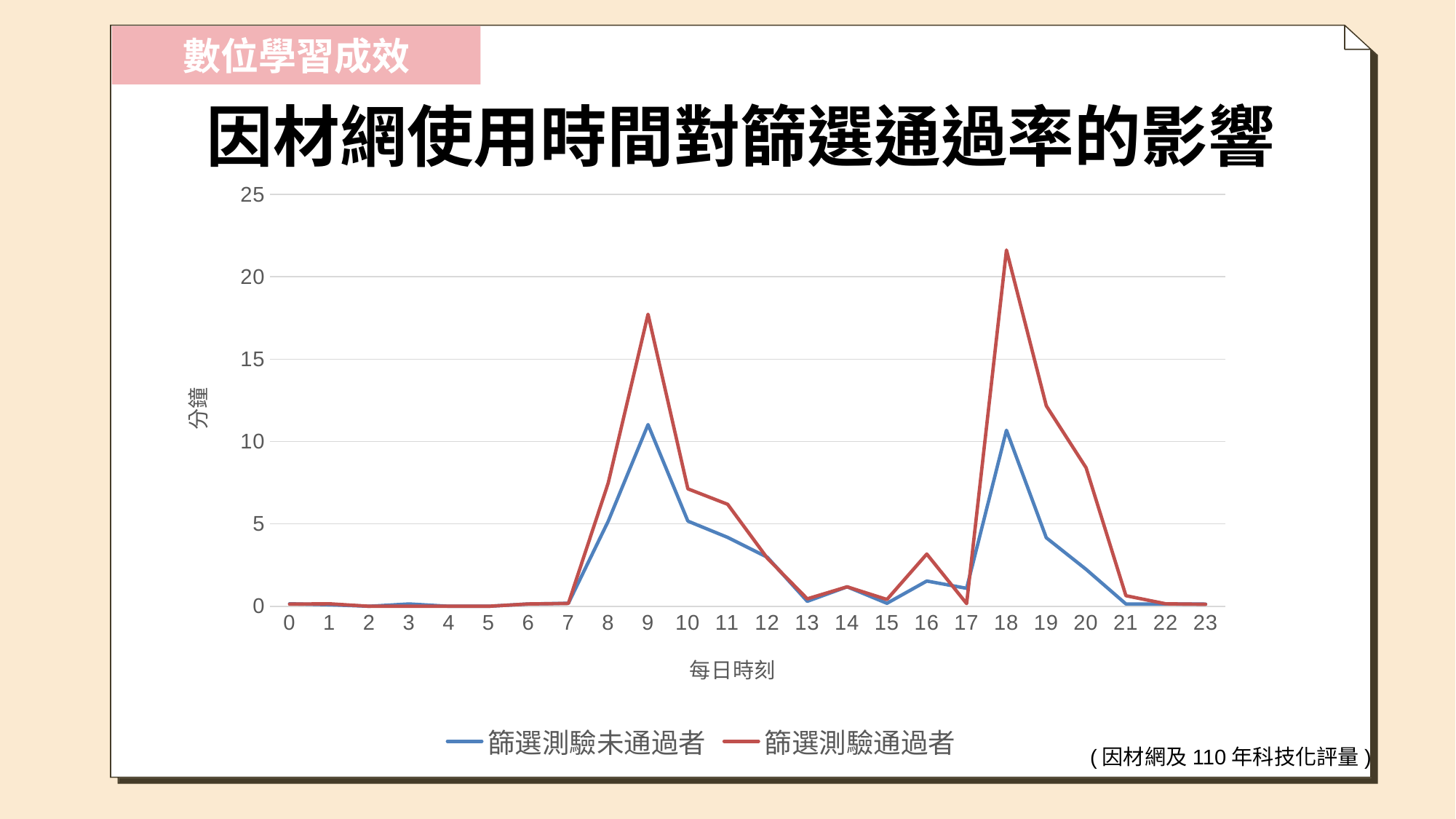
Is the value for 篩選測驗通過者 at hour 9 greater or less than 15? greater Is the value for 篩選測驗未通過者 at hour 18 greater or less than 15? less What is the label on the y axis? 分鐘 Is the value for 篩選測驗通過者 at hour 18 greater or less than 20? greater Does the 篩選測驗通過者 series rise or fall from hour 18 to hour 21? fall What is the label on the x axis? 每日時刻 At hour 18, which series has the larger value, 篩選測驗通過者 or 篩選測驗未通過者? 篩選測驗通過者 How many series does the legend list? 2 What kind of chart is shown on the slide? line chart How many hourly points are plotted along the x axis? 24 At which hour does the 篩選測驗通過者 series reach its highest value? 18